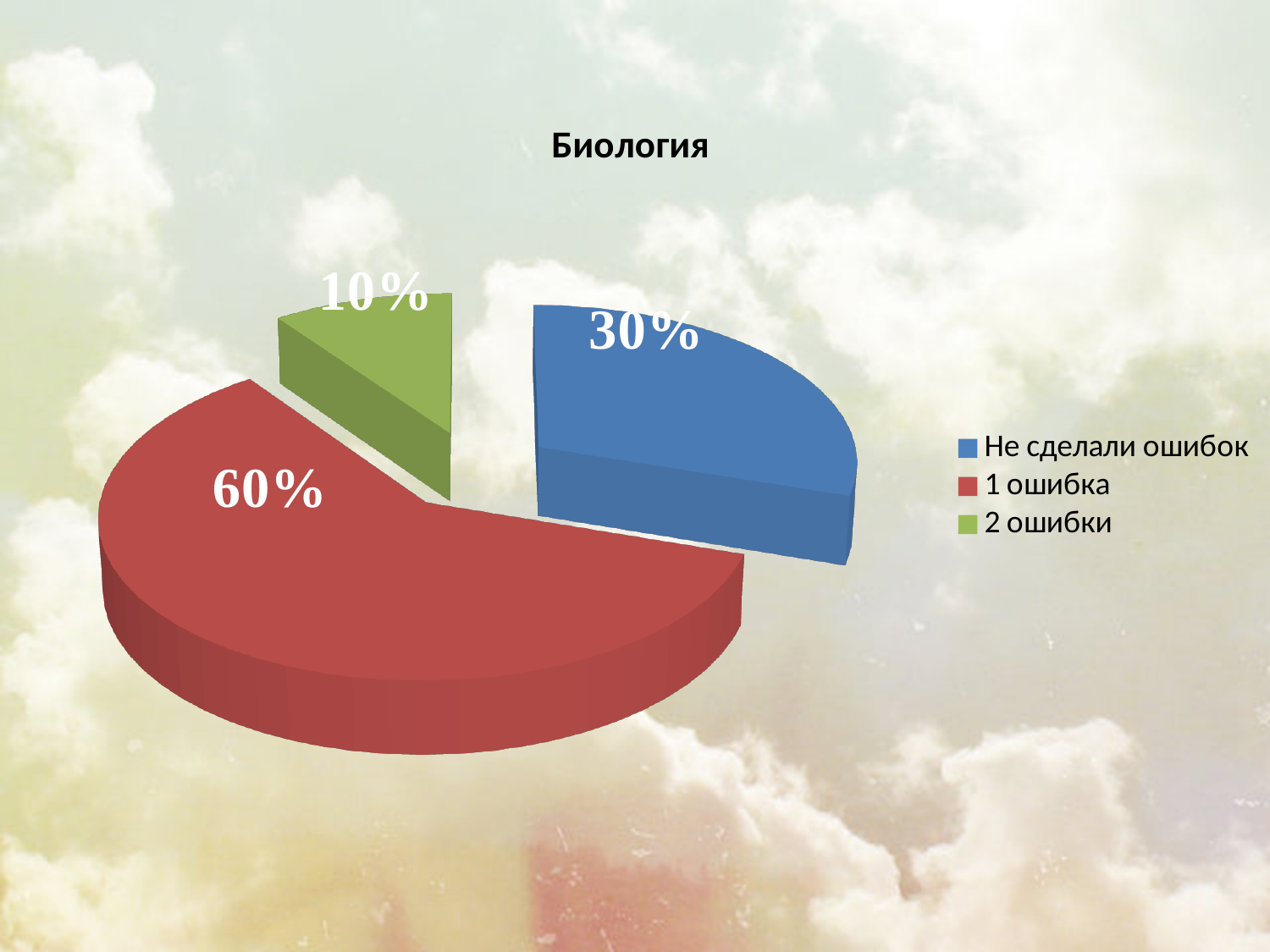
Which category has the smallest slice? 2 ошибки What share of the pie does "Не сделали ошибок" take? 30% What is the title of the chart? Биология What is the difference between the shares for "Не сделали ошибок" and "2 ошибки"? 20% What is the difference between the shares for "1 ошибка" and "Не сделали ошибок"? 30% Which is larger, the share for "Не сделали ошибок" or the share for "2 ошибки"? Не сделали ошибок What share of the pie does "1 ошибка" take? 60% How many categories does the pie chart have? 3 What kind of chart is shown on the slide? pie chart What share of the pie does "2 ошибки" take? 10% What colour is the slice for "2 ошибки"? green Which category has the largest slice? 1 ошибка